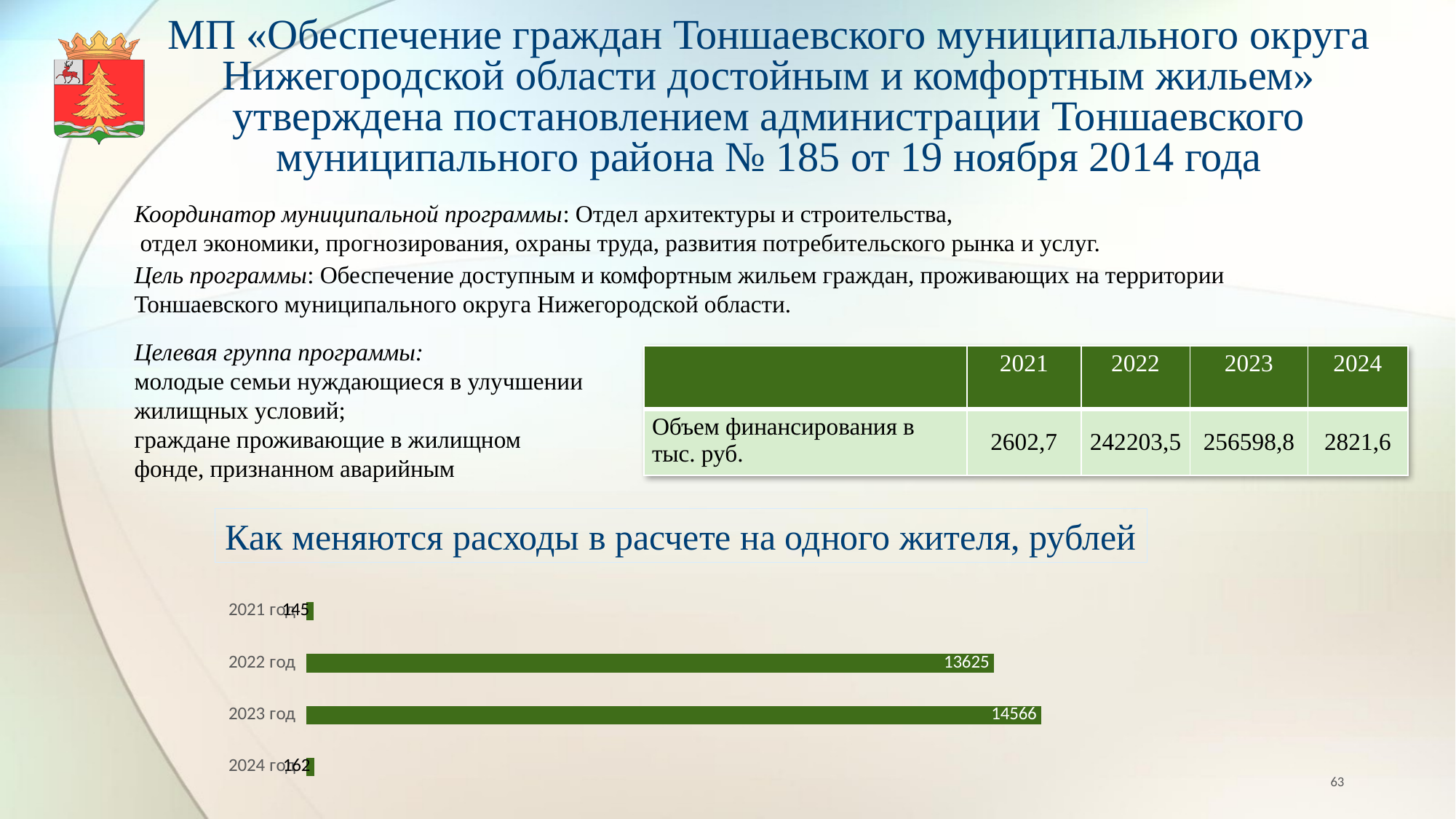
How many years are shown in the chart? 4 What is the difference between the values for 2024 год and 2021 год? 17 What is the value for 2024 год in the chart? 162 What is the value for 2023 год in the chart? 14566 Which is larger, the value for 2022 год or the value for 2024 год? 2022 год What is the value for 2022 год in the chart? 13625 What is the difference between the values for 2023 год and 2022 год? 941 Which year has the lowest value in the chart? 2021 год What is the value for 2021 год in the chart? 145 Which year has the highest value in the chart? 2023 год What kind of chart is shown on the slide? Bar chart What is the title of the chart? Как меняются расходы в расчете на одного жителя, рублей